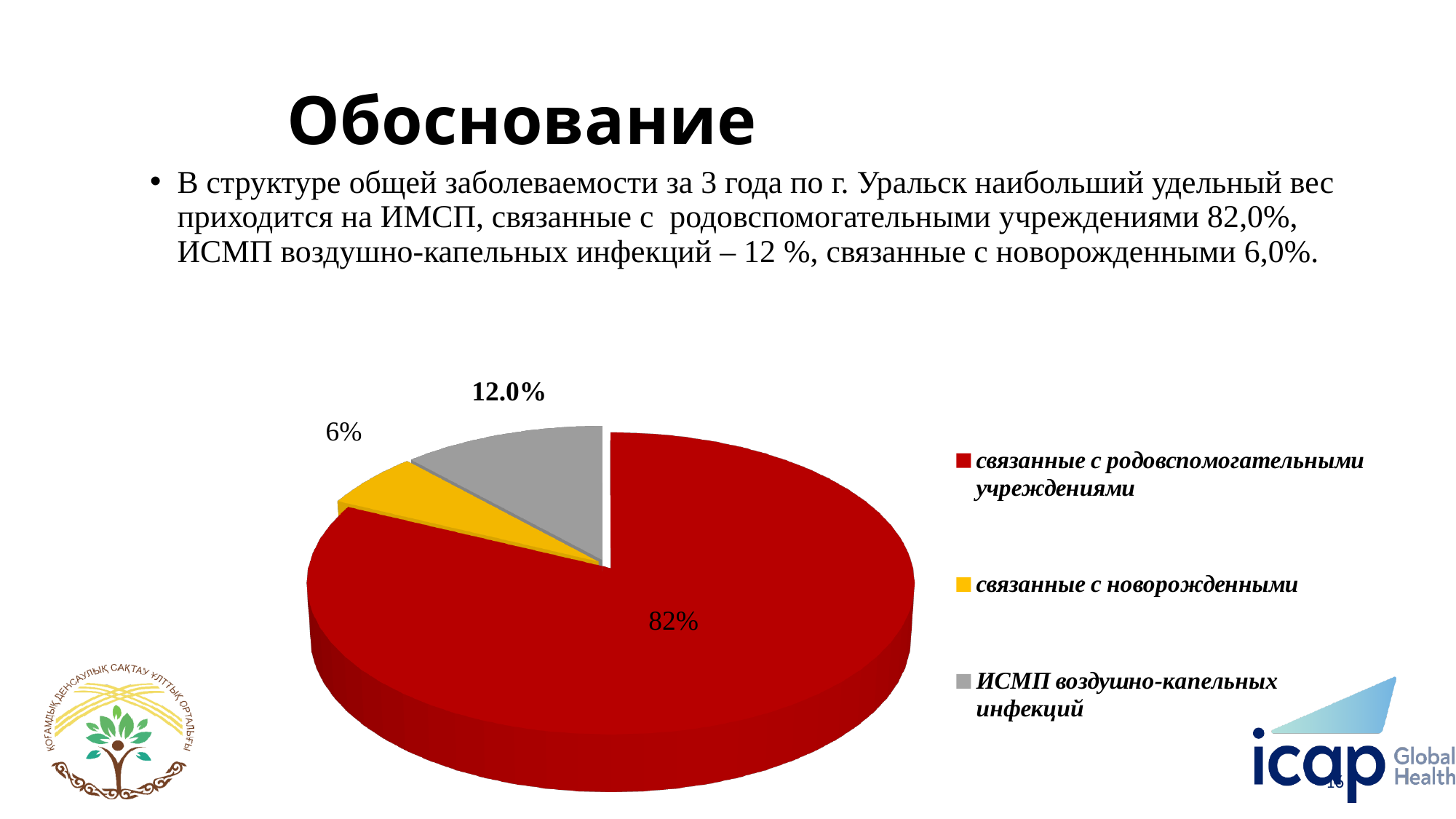
How many entries does the legend of the pie chart list? 3 What share of the pie is labelled for 'связанные с родовспомогательными учреждениями'? 82% What is the difference in percentage points between the 'связанные с родовспомогательными учреждениями' slice and the 'ИСМП воздушно-капельных инфекций' slice? 70 What share of the pie is labelled for 'связанные с новорожденными'? 6% What share of the pie is labelled for 'ИСМП воздушно-капельных инфекций'? 12.0% Which category has the largest slice of the pie? связанные с родовспомогательными учреждениями Which category has the smallest slice of the pie? связанные с новорожденными How many slices does the pie chart have? 3 What colour is the slice for 'ИСМП воздушно-капельных инфекций' in the pie chart? gray Which slice is larger: 'ИСМП воздушно-капельных инфекций' or 'связанные с новорожденными'? ИСМП воздушно-капельных инфекций What kind of chart is shown on the slide? pie chart What colour is the slice for 'связанные с новорожденными' in the pie chart? yellow